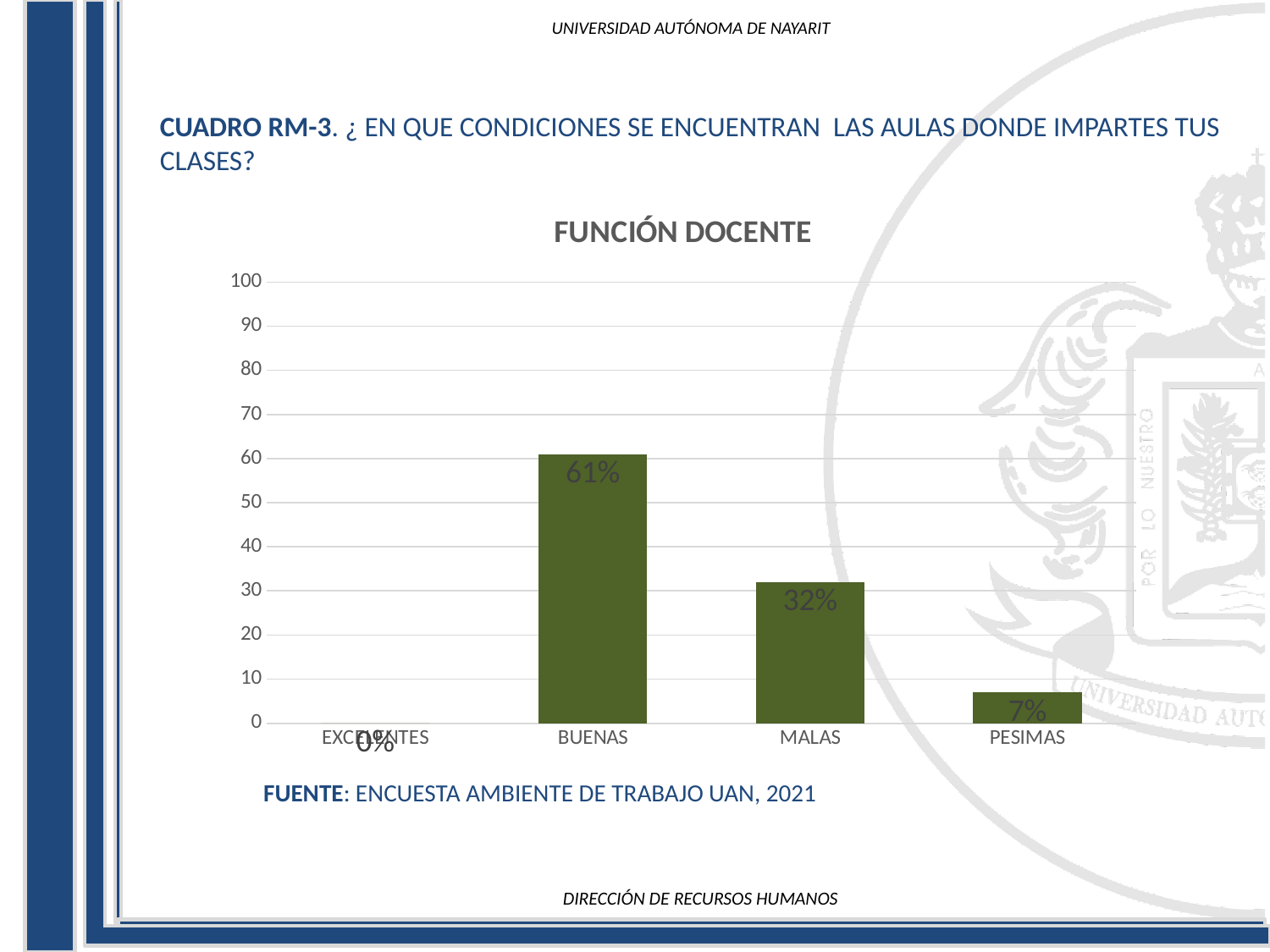
What is the value for PESIMAS? 7% What is the value for MALAS? 32% Which category has the lowest value? EXCELENTES Which category has the highest value? BUENAS What is the title of the chart? FUNCIÓN DOCENTE What is the difference between the values for BUENAS and MALAS? 29% Is the value for BUENAS greater or less than 50? greater What is the value for EXCELENTES? 0% How many categories are shown on the x axis? 4 Which is larger, the value for MALAS or the value for PESIMAS? MALAS What is the value for BUENAS? 61% What kind of chart is shown on the slide? bar chart